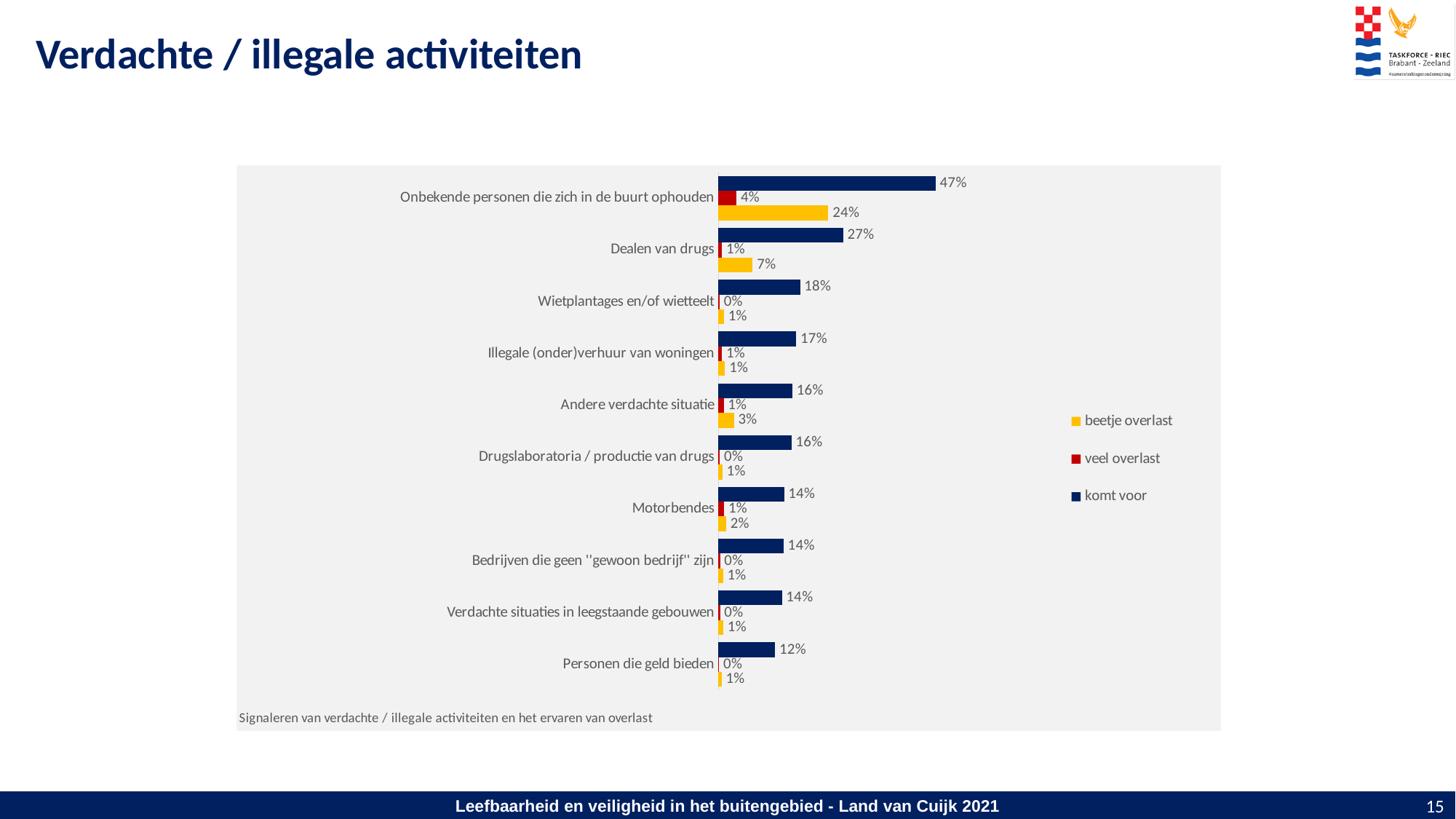
How many categories are shown on the chart? 10 What is the 'komt voor' value for 'Onbekende personen die zich in de buurt ophouden'? 47% How many series does the legend list? 3 What kind of chart is shown on the slide? Bar chart What is the difference between the 'komt voor' values for 'Onbekende personen die zich in de buurt ophouden' and 'Dealen van drugs'? 20% What is the 'beetje overlast' value for 'Dealen van drugs'? 7% Which colour represents the 'veel overlast' series in the legend? Red What is the 'komt voor' value for 'Personen die geld bieden'? 12% Which category has the highest 'komt voor' value? Onbekende personen die zich in de buurt ophouden What is the 'veel overlast' value for 'Onbekende personen die zich in de buurt ophouden'? 4% Which category has the lowest 'komt voor' value? Personen die geld bieden Which is larger: the 'beetje overlast' value for 'Andere verdachte situatie' or for 'Motorbendes'? Andere verdachte situatie